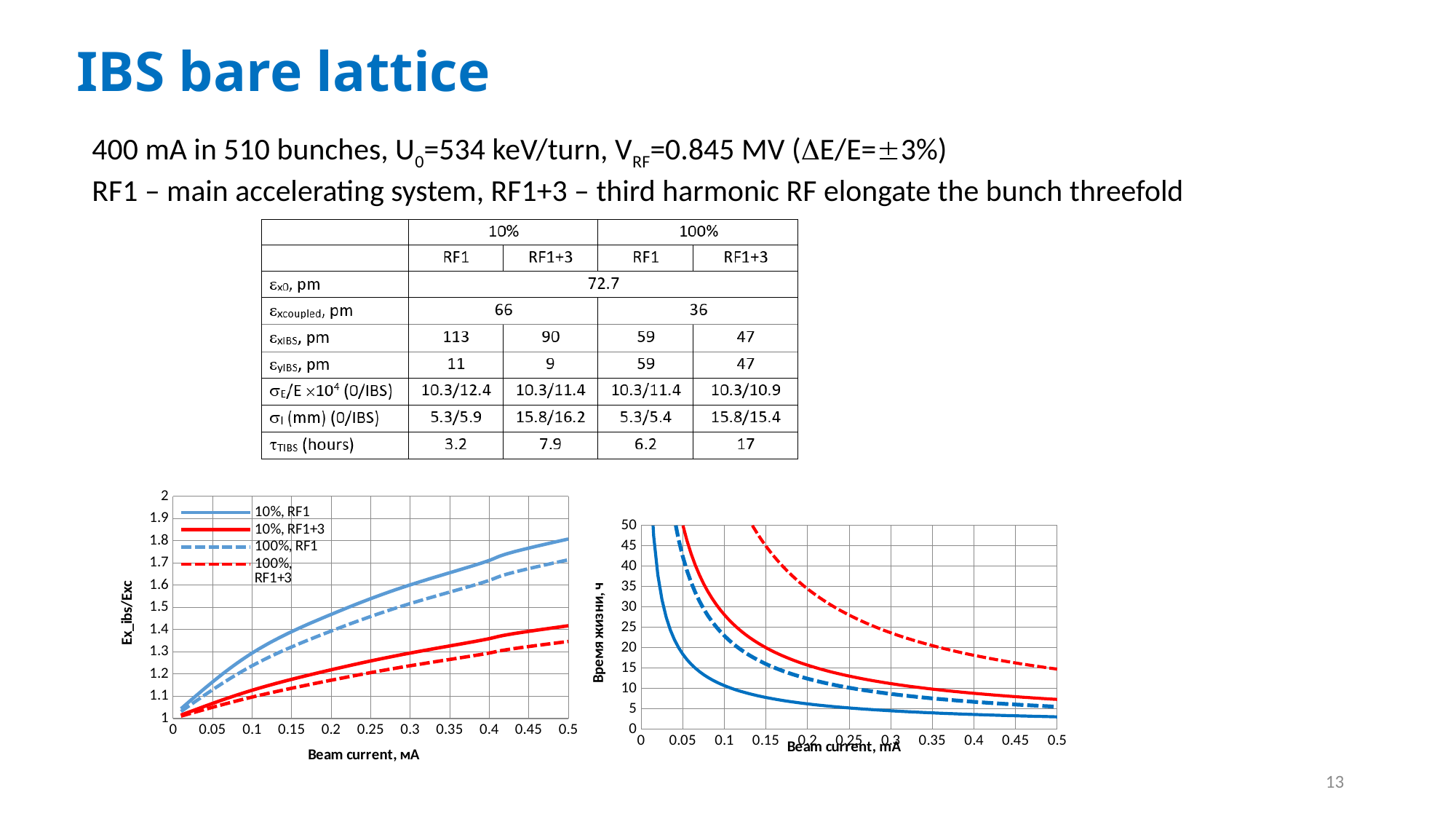
What is the x-axis title of the left chart? Beam current, мА In the left chart (Ex_ibs/Exc), is the value for 10%, RF1 at 0.5 mA greater or less than 1.7? greater What is the y-axis title of the right chart? Время жизни, ч What kind of chart is the left chart (Ex_ibs/Exc vs Beam current)? line chart How many series does the legend of the left chart (Ex_ibs/Exc) list? 4 In the left chart (Ex_ibs/Exc), which is larger at 0.5 mA: 10%, RF1 or 100%, RF1+3? 10%, RF1 In the right chart, is the value of the red dashed line at 0.5 mA greater or less than 10? greater In the left chart (Ex_ibs/Exc), is the value for 10%, RF1+3 at 0.5 mA greater or less than 1.5? less In the left chart (Ex_ibs/Exc), which series has the lowest value at 0.5 mA? 100%, RF1+3 In the left chart (Ex_ibs/Exc), which series has the highest value at 0.5 mA? 10%, RF1 In the left chart (Ex_ibs/Exc), do the values rise or fall as beam current increases? rise In the right chart (Время жизни, ч), do the values rise or fall as beam current increases? fall